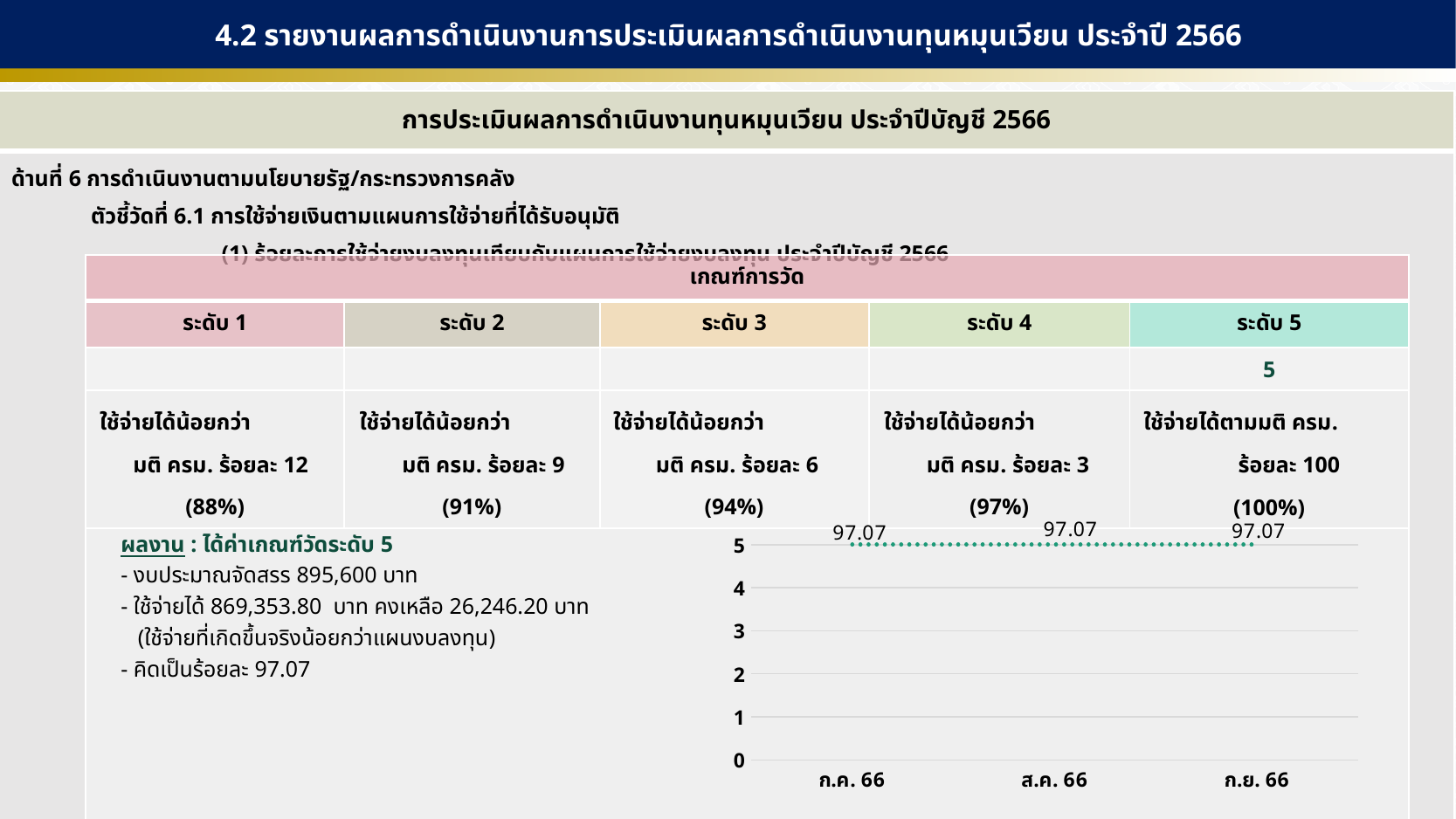
What type of chart is shown at the bottom right of the slide? line chart What is the data label for ก.ค. 66 on the line chart? 97.07 What is the highest value shown on the y axis of the line chart? 5 What is the data label for ก.ย. 66 on the line chart? 97.07 How many data points are plotted on the line chart? 3 What is the difference between the data labels for ก.ค. 66 and ก.ย. 66 on the line chart? 0 What is the data label for ส.ค. 66 on the line chart? 97.07 Do the values on the line chart rise, fall, or stay flat from ก.ค. 66 to ก.ย. 66? stay flat Is the plotted point for ส.ค. 66 on the line chart at a level greater or less than 4 on the y axis? greater What is the first category on the x axis of the line chart? ก.ค. 66